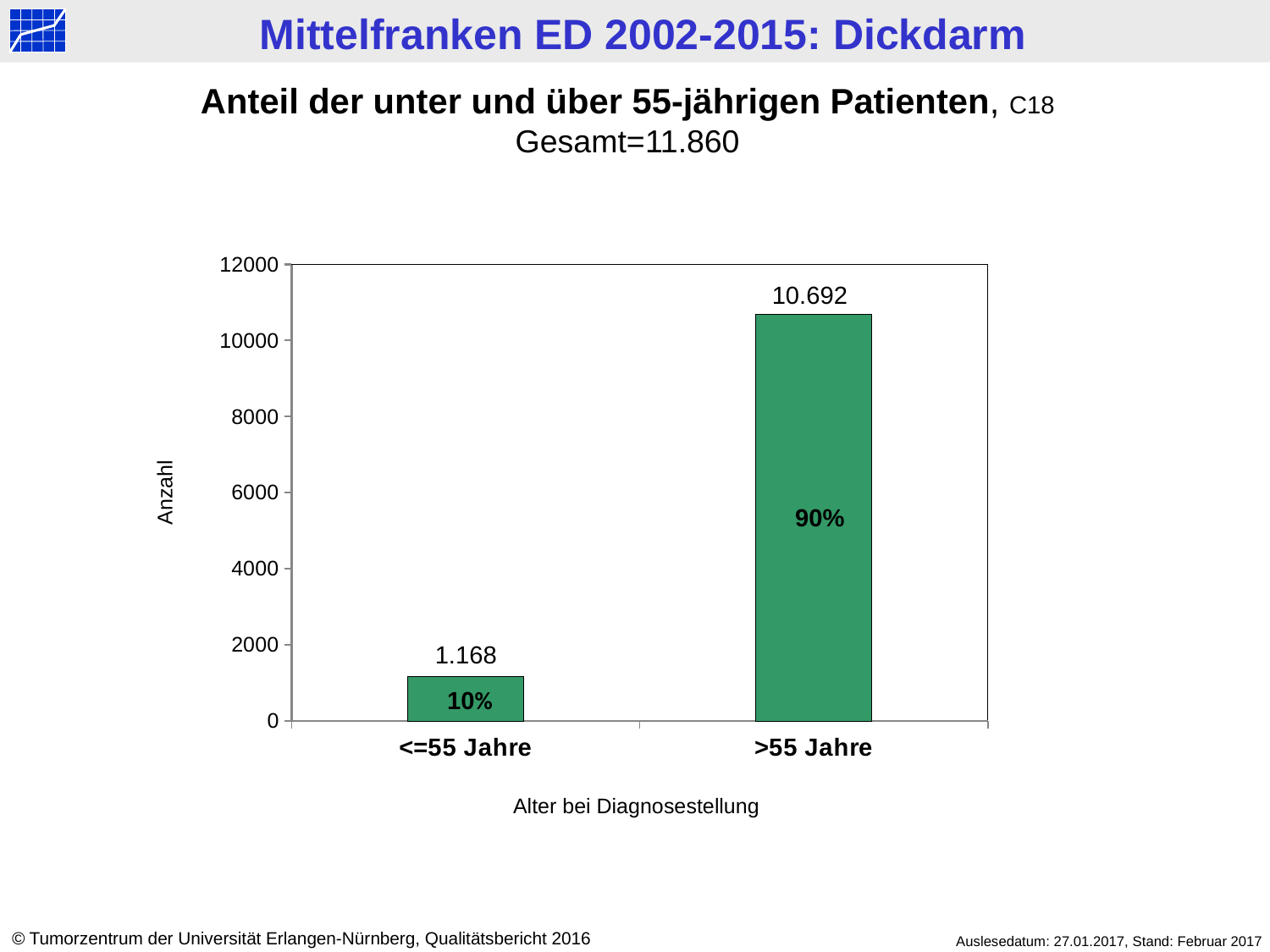
How many categories are shown on the x axis? 2 What is the label of the x axis? Alter bei Diagnosestellung What percentage is shown on the "<=55 Jahre" bar? 10% Is the value for ">55 Jahre" greater or less than 10000? greater What is the value for the "<=55 Jahre" category? 1.168 What percentage is shown on the ">55 Jahre" bar? 90% What is the difference between the values for ">55 Jahre" and "<=55 Jahre"? 9.524 What kind of chart is shown on the slide? bar chart What is the value for the ">55 Jahre" category? 10.692 Which category has the lowest value? <=55 Jahre Which is larger, the value for "<=55 Jahre" or the value for ">55 Jahre"? >55 Jahre Which category has the highest value? >55 Jahre